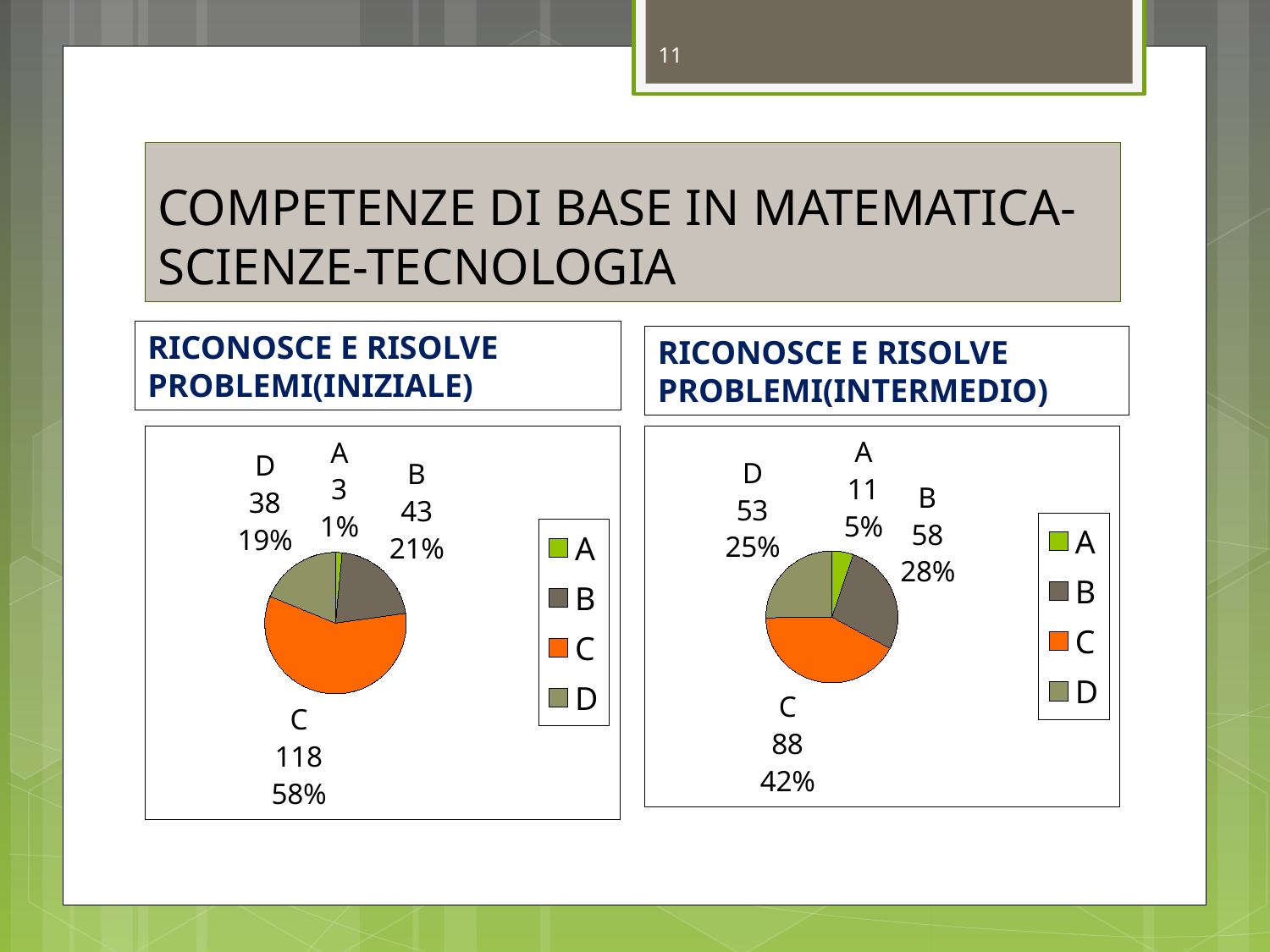
In the left pie chart (INIZIALE), what is the difference between the values for B and D? 5 In the right pie chart (INTERMEDIO), which is larger, the value for A or the value for D? D In the right pie chart (INTERMEDIO), which category has the largest slice? C In the left pie chart (INIZIALE), what percentage share does D have? 19% In the right pie chart (RICONOSCE E RISOLVE PROBLEMI(INTERMEDIO)), what is the value for B? 58 In the left pie chart (INIZIALE), which category has the smallest slice? A What type of chart is used on the right side of the slide (INTERMEDIO)? Pie chart In the right pie chart (INTERMEDIO), what is the difference between the values for C and D? 35 How many categories does the legend of the left pie chart (INIZIALE) list? 4 In the right pie chart (INTERMEDIO), what percentage share does C have? 42% In the left pie chart (INIZIALE), what colour represents category C in the legend? Orange In the left pie chart (RICONOSCE E RISOLVE PROBLEMI(INIZIALE)), what is the value for C? 118